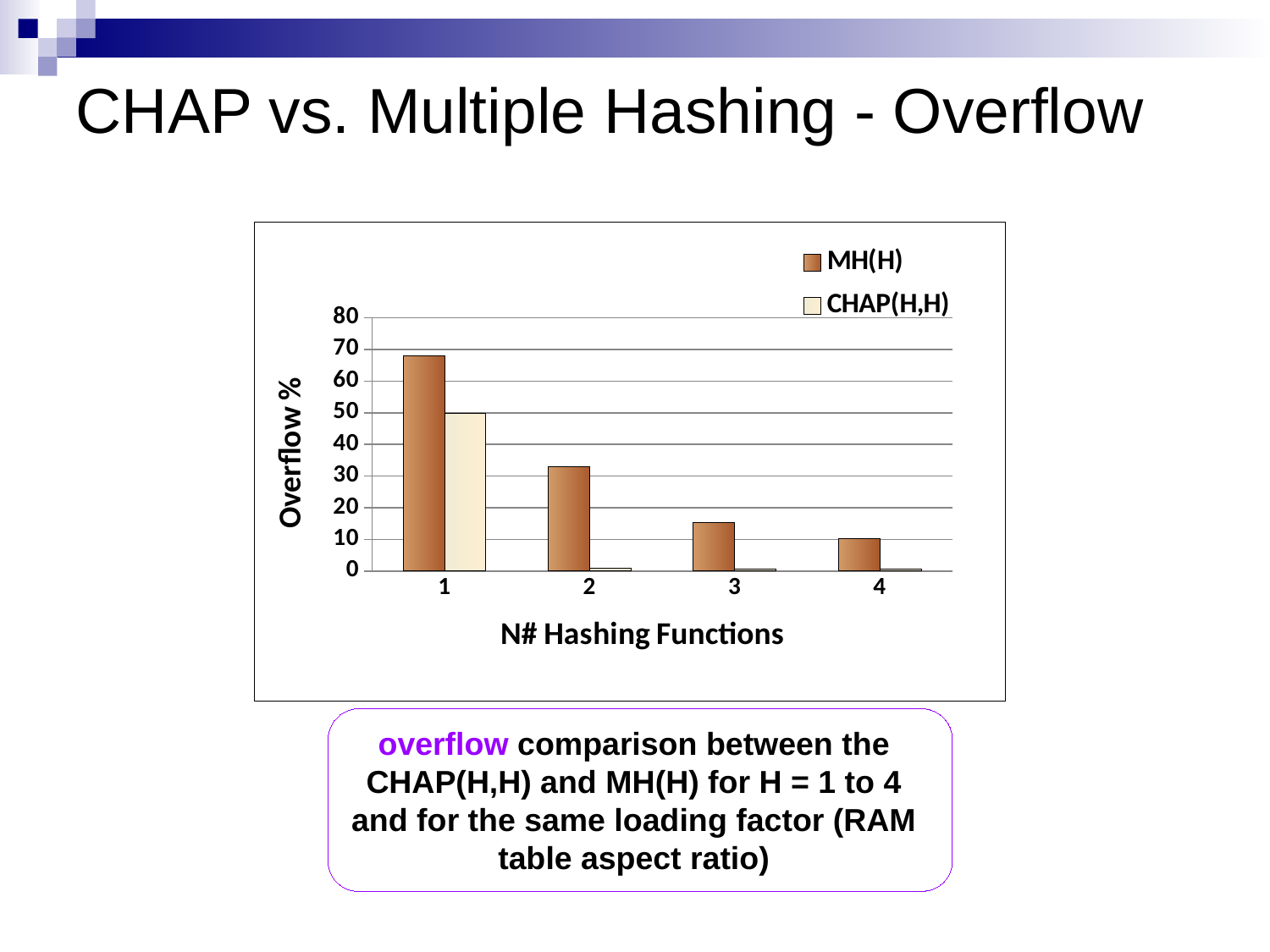
How many series does the chart legend list? 2 What kind of chart is shown on the slide? bar chart Is the MH(H) overflow for 1 hashing function greater or less than 60? greater At 1 hashing function, which series has the larger overflow, MH(H) or CHAP(H,H)? MH(H) How many categories are shown on the x axis of the chart? 4 Is the MH(H) overflow for 2 hashing functions greater or less than 40? less What is the label of the vertical axis of the chart? Overflow % Is the MH(H) overflow for 3 hashing functions greater or less than 20? less For which number of hashing functions is the MH(H) overflow lowest? 4 For which number of hashing functions is the MH(H) overflow highest? 1 Does the MH(H) overflow rise or fall as the number of hashing functions increases from 1 to 4? fall